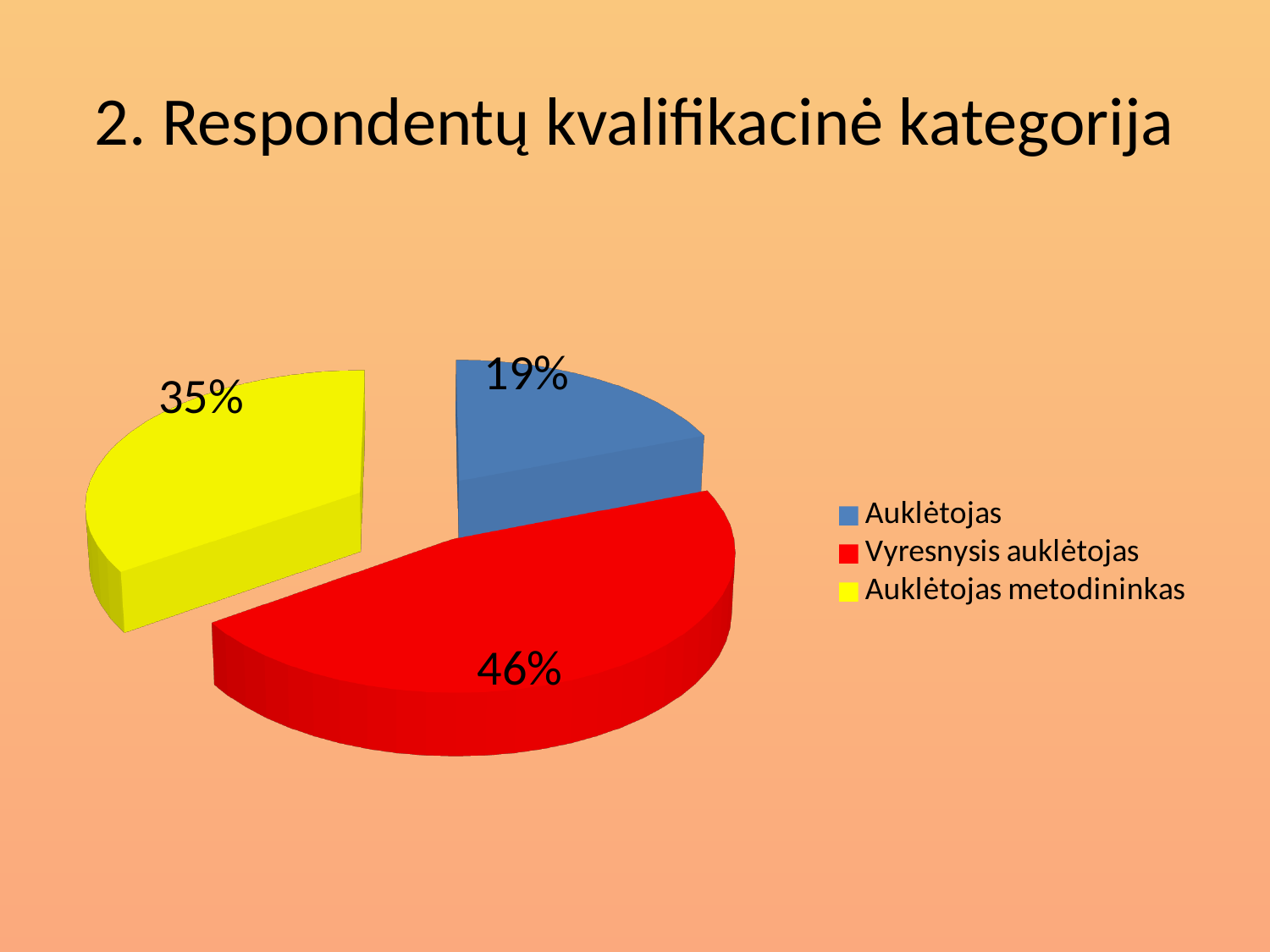
What is the difference in percentage points between Vyresnysis auklėtojas and Auklėtojas metodininkas? 11 What is the title of the slide? 2. Respondentų kvalifikacinė kategorija Which category has the smallest share of the pie? Auklėtojas What is the difference in percentage points between Auklėtojas metodininkas and Auklėtojas? 16 What share of respondents are Vyresnysis auklėtojas? 46% How many categories does the pie chart have? 3 What colour is the slice for Vyresnysis auklėtojas? red Which category has the largest share of the pie? Vyresnysis auklėtojas What share of respondents are Auklėtojas? 19% What share of respondents are Auklėtojas metodininkas? 35% Which is larger, the share for Auklėtojas or the share for Auklėtojas metodininkas? Auklėtojas metodininkas What kind of chart is shown on the slide? pie chart